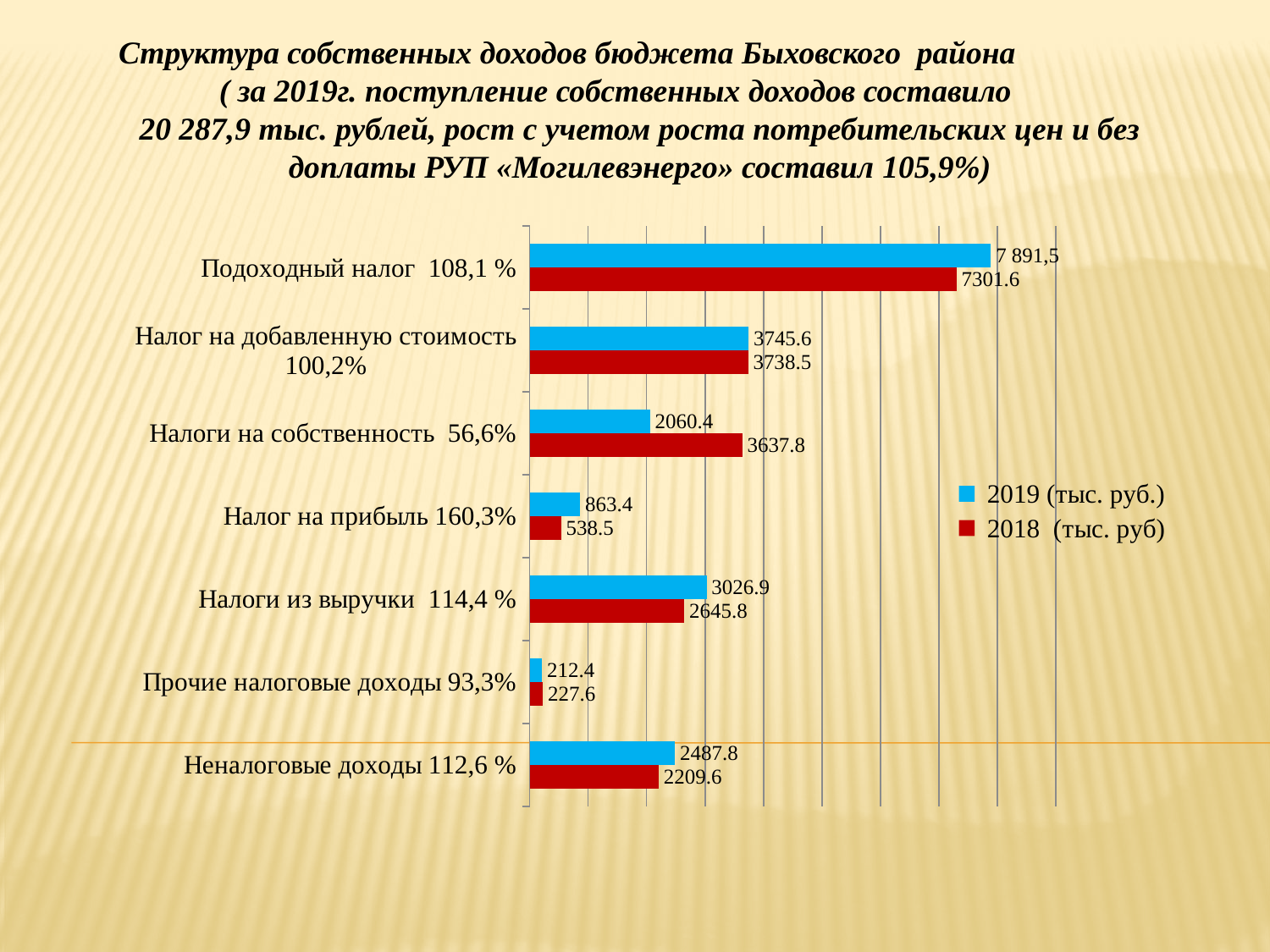
For Налоги на собственность, which series has the larger value, 2019 or 2018? 2018 How many series does the legend list? 2 What is the 2019 (тыс. руб.) value for Налоги из выручки? 3026.9 What is the difference between the 2018 and 2019 values for Налоги на собственность? 1577.4 Which category has the lowest 2018 (тыс. руб) value? Прочие налоговые доходы What is the difference between the 2019 and 2018 values for Налог на прибыль? 324.9 Which category has the highest 2019 (тыс. руб.) value? Подоходный налог What is the 2018 (тыс. руб) value for Прочие налоговые доходы? 227.6 What is the 2018 (тыс. руб) value for Налоги на собственность? 3637.8 What is the 2019 (тыс. руб.) value for Подоходный налог? 7 891,5 How many categories are shown in the chart? 7 What kind of chart is shown on the slide? Bar chart